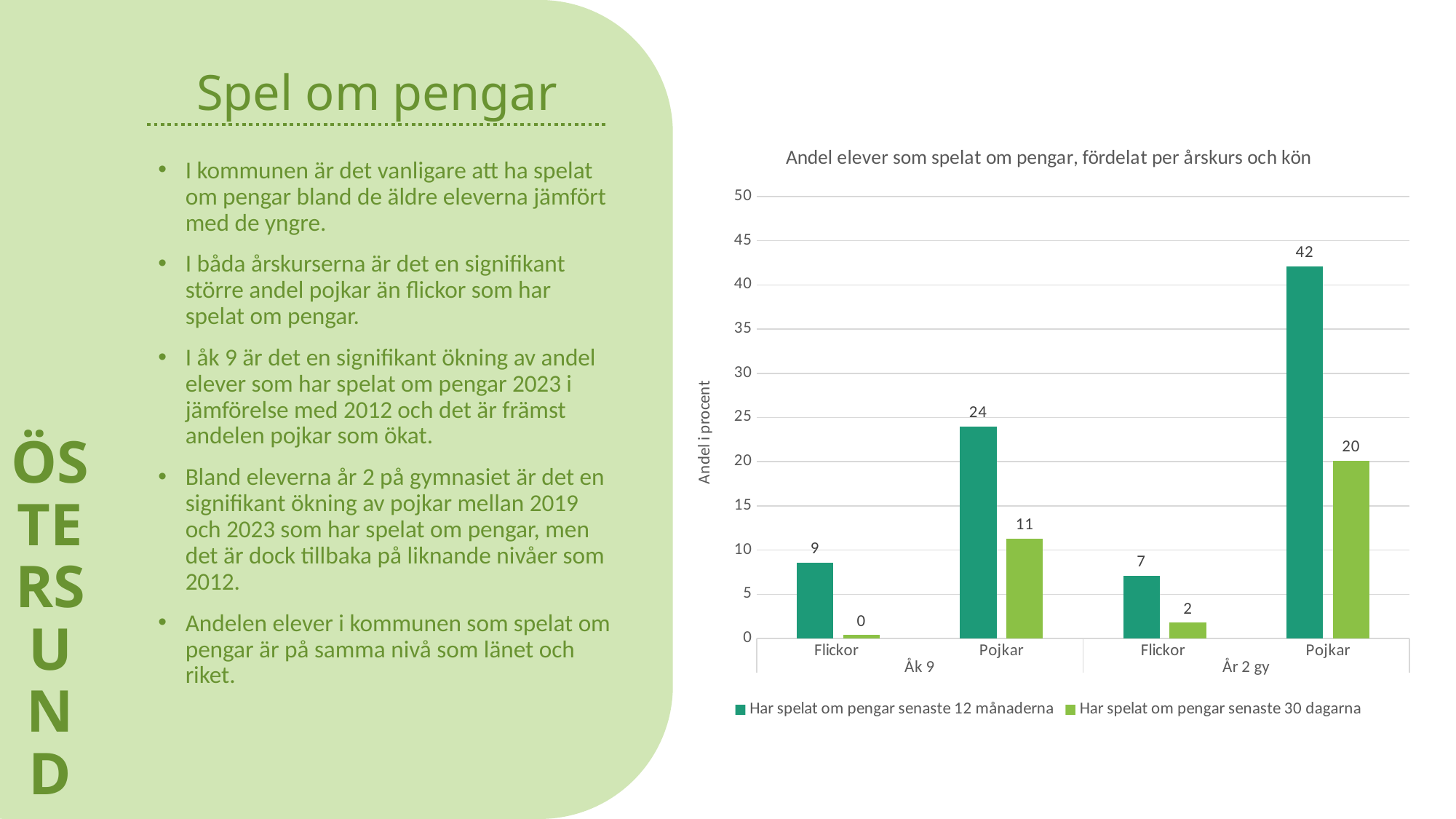
Which group has the lowest value for 'Har spelat om pengar senaste 30 dagarna'? Flickor, Åk 9 What is the value for Pojkar in Åk 9 for the series 'Har spelat om pengar senaste 12 månaderna'? 24 What is the difference between Pojkar and Flickor in År 2 gy for 'Har spelat om pengar senaste 12 månaderna'? 35 Which is larger: the 12-month value for Flickor in Åk 9 or the 12-month value for Flickor in År 2 gy? Flickor in Åk 9 How many series does the legend list? 2 Is the 30-day value for Pojkar in År 2 gy greater or less than 15? greater Which group has the highest value for 'Har spelat om pengar senaste 12 månaderna'? Pojkar, År 2 gy What is the value for Pojkar in År 2 gy for the series 'Har spelat om pengar senaste 12 månaderna'? 42 What is the difference between the two series for Pojkar in Åk 9? 13 What kind of chart is shown on the slide? Bar chart What is the value for Flickor in År 2 gy for the series 'Har spelat om pengar senaste 30 dagarna'? 2 What is the title of the chart? Andel elever som spelat om pengar, fördelat per årskurs och kön